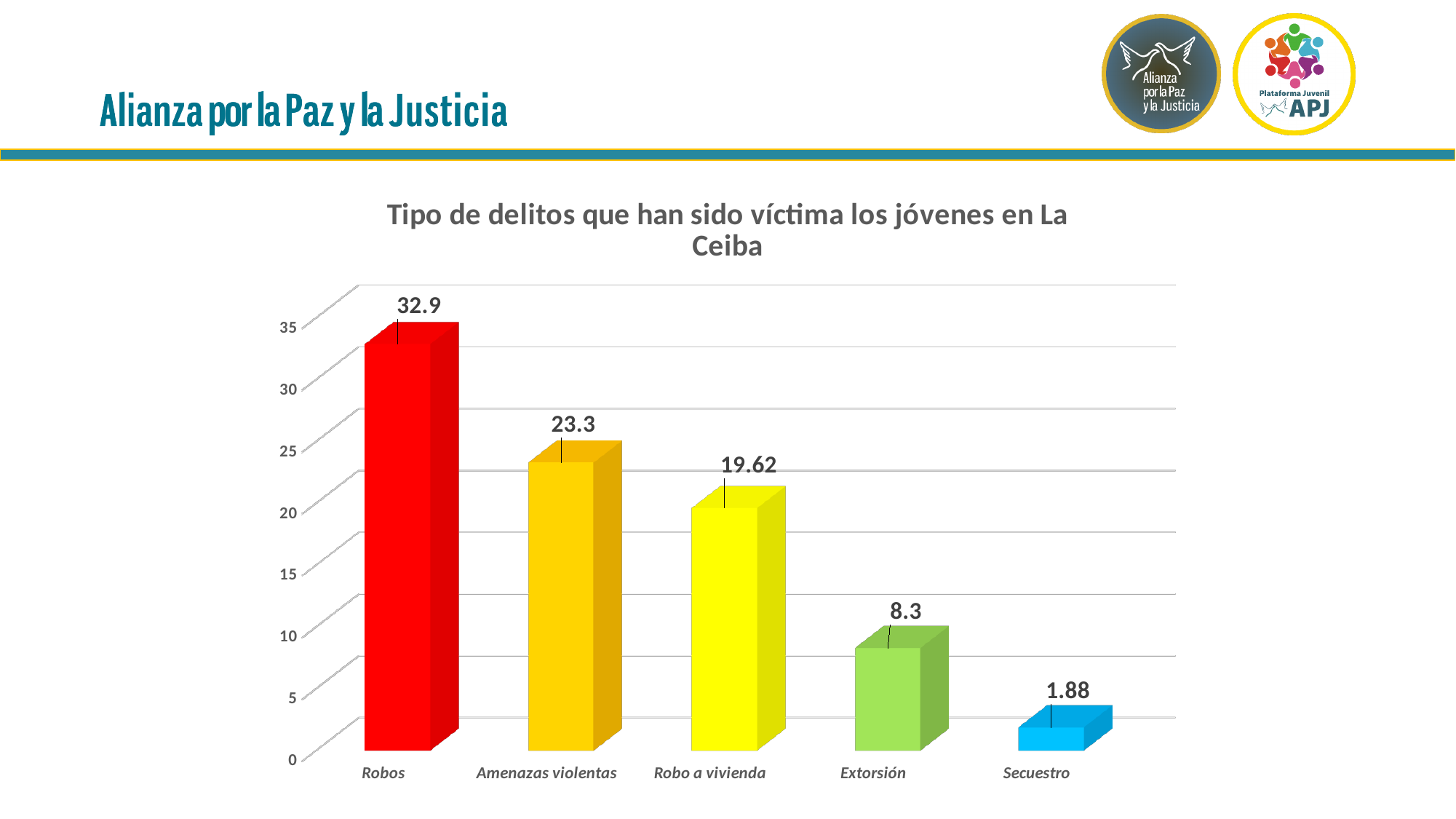
What is the value for Robos? 32.9 What is the difference between the values for Extorsión and Secuestro? 6.42 How many categories are shown on the x axis? 5 What is the value for Amenazas violentas? 23.3 Which is larger, the value for Robo a vivienda or the value for Extorsión? Robo a vivienda What is the difference between the values for Robos and Amenazas violentas? 9.6 What is the value for Secuestro? 1.88 Which category has the highest value? Robos What is the value for Robo a vivienda? 19.62 What kind of chart is shown on the slide? Bar chart Which category has the lowest value? Secuestro What is the title of the chart? Tipo de delitos que han sido víctima los jóvenes en La Ceiba